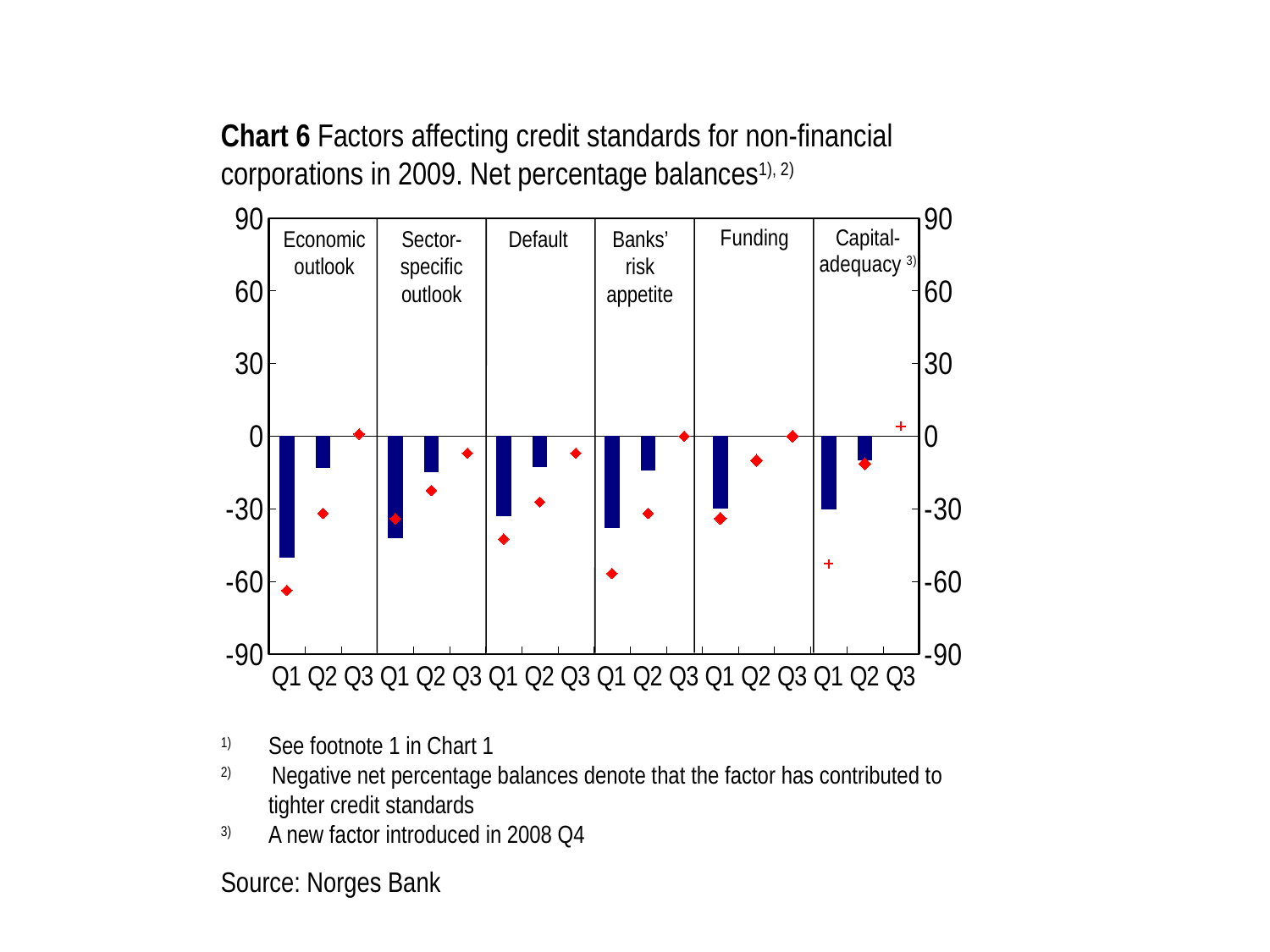
Which factor has the lowest (most negative) Q1 bar? Economic outlook What kind of chart is shown on the slide? Bar chart with red markers (combination bar and marker chart) Is the Q1 bar for Banks' risk appetite greater or less than -30? less Is the Q1 bar for Economic outlook greater or less than -30? less Is the Q2 bar for Economic outlook greater or less than -30? greater Do the bars for Economic outlook rise or fall from Q1 to Q3? rise According to footnote 3, when was the Capital adequacy factor introduced? 2008 Q4 How many quarters are plotted for each factor? 3 How many factors (panels) are shown in the chart? 6